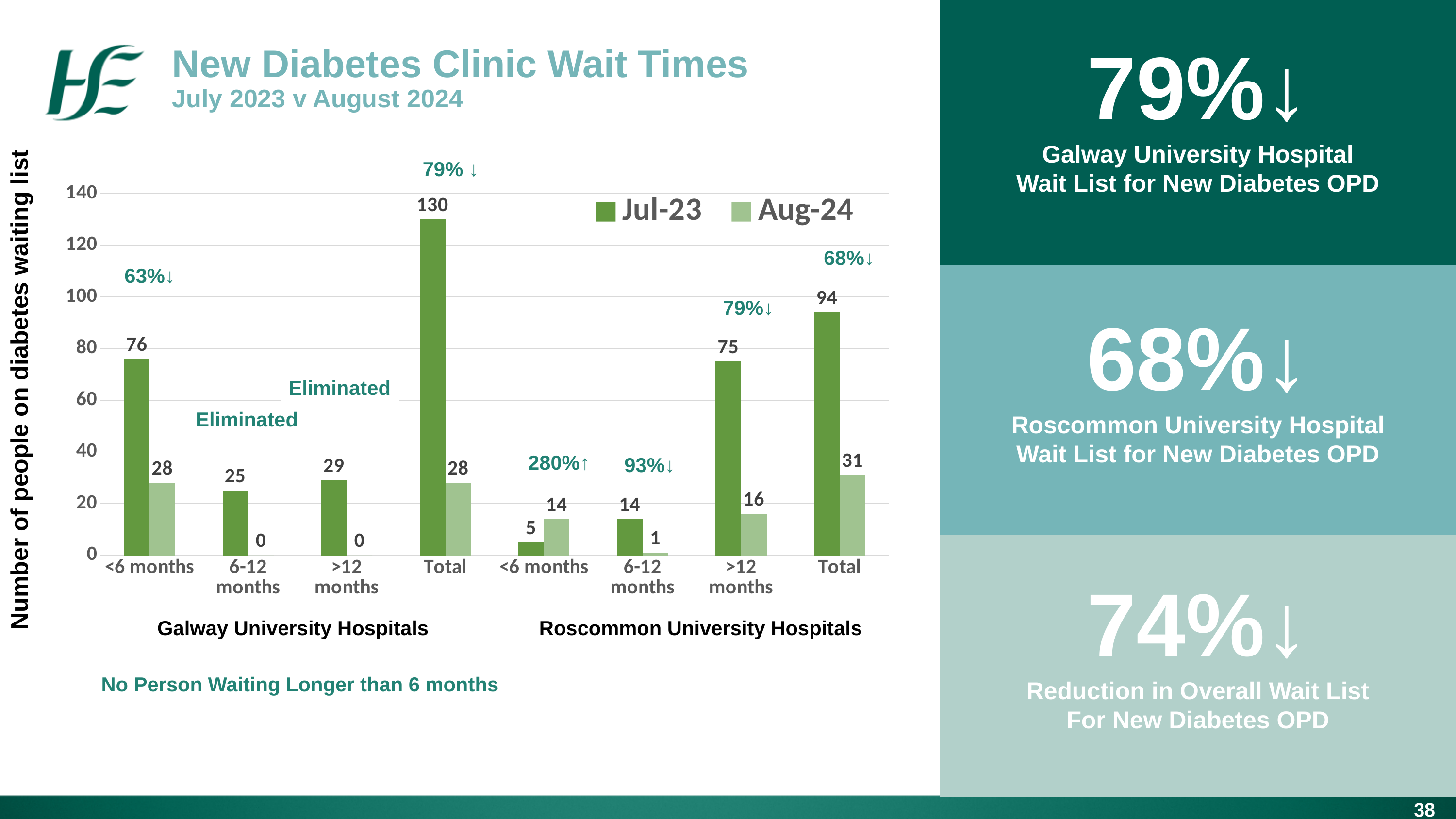
What is the Jul-23 value for Total at Galway University Hospitals? 130 What is the difference between the Jul-23 and Aug-24 values for <6 months at Galway University Hospitals? 48 Which category has the highest Jul-23 value? Total (Galway University Hospitals) How many series does the legend list? 2 Is the Jul-23 value for Total at Galway University Hospitals greater or less than 120? greater What kind of chart is shown on the slide? bar chart What is the Aug-24 value for 6-12 months at Galway University Hospitals? 0 For <6 months at Roscommon University Hospitals, which is larger, the Jul-23 value or the Aug-24 value? Aug-24 What is the Aug-24 value for <6 months at Roscommon University Hospitals? 14 What is the difference between the Jul-23 and Aug-24 values for Total at Roscommon University Hospitals? 63 What is the Jul-23 value for >12 months at Roscommon University Hospitals? 75 What percentage change is annotated above the Total bars for Roscommon University Hospitals? 68%↓